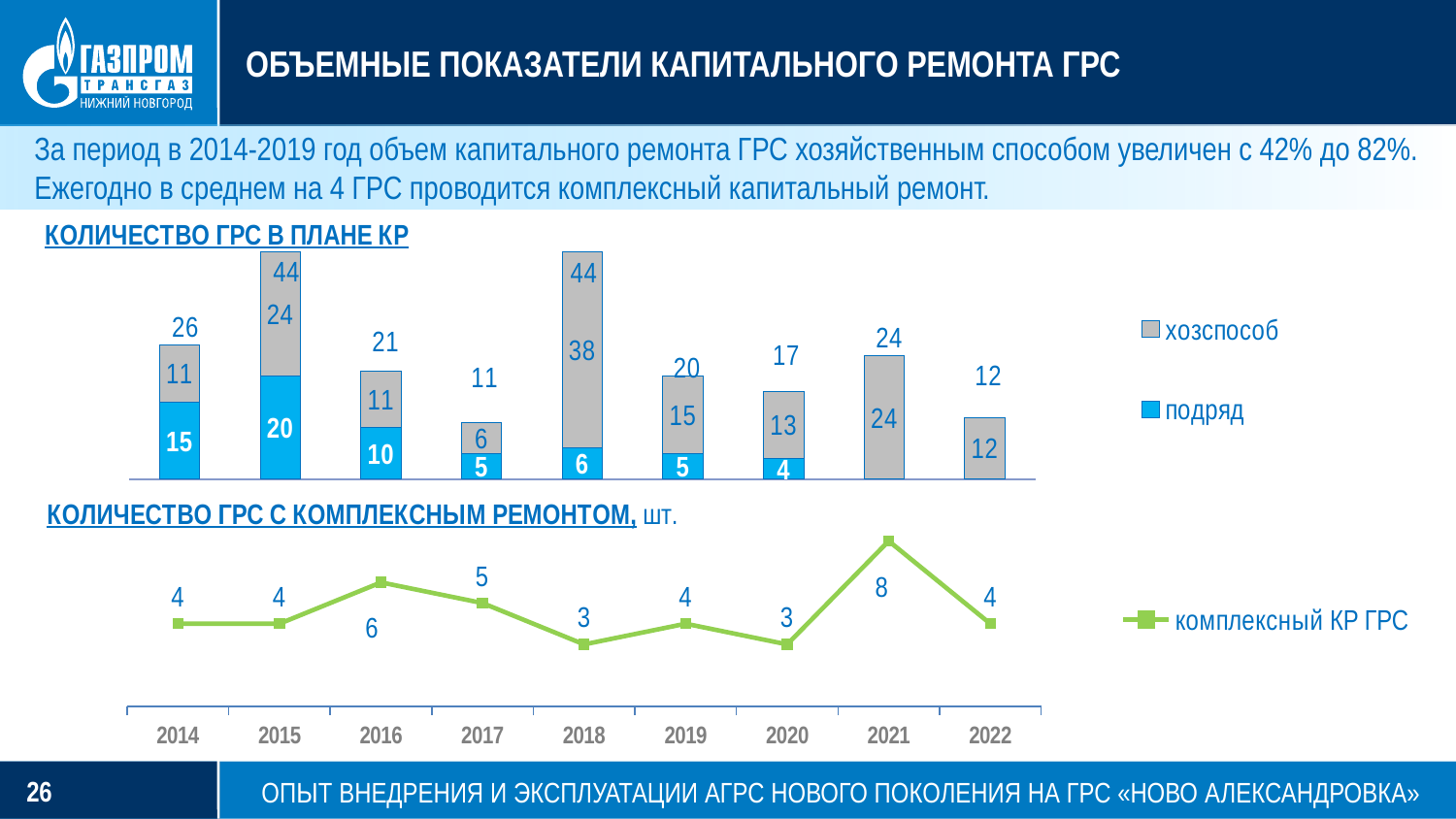
On the chart 'КОЛИЧЕСТВО ГРС В ПЛАНЕ КР', which year has the lowest stacked bar total? 2017 On the chart 'КОЛИЧЕСТВО ГРС С КОМПЛЕКСНЫМ РЕМОНТОМ', which year has the highest value? 2021 On the chart 'КОЛИЧЕСТВО ГРС С КОМПЛЕКСНЫМ РЕМОНТОМ', does the value rise or fall from 2021 to 2022? fall On the chart 'КОЛИЧЕСТВО ГРС В ПЛАНЕ КР', what is the value for 'хозспособ' in 2018? 38 On the chart 'КОЛИЧЕСТВО ГРС С КОМПЛЕКСНЫМ РЕМОНТОМ', what is the value for 2021? 8 On the chart 'КОЛИЧЕСТВО ГРС В ПЛАНЕ КР', what is the value for 'подряд' in 2015? 20 On the chart 'КОЛИЧЕСТВО ГРС В ПЛАНЕ КР', what is the total of the stacked bar for 2014? 26 How many years are plotted on the chart 'КОЛИЧЕСТВО ГРС С КОМПЛЕКСНЫМ РЕМОНТОМ'? 9 On the chart 'КОЛИЧЕСТВО ГРС В ПЛАНЕ КР', what is the difference between the 'хозспособ' value and the 'подряд' value in 2019? 10 What kind of chart is 'КОЛИЧЕСТВО ГРС В ПЛАНЕ КР'? stacked bar chart How many series does the legend of the chart 'КОЛИЧЕСТВО ГРС В ПЛАНЕ КР' list? 2 On the chart 'КОЛИЧЕСТВО ГРС В ПЛАНЕ КР', which is larger in 2014: 'подряд' or 'хозспособ'? подряд